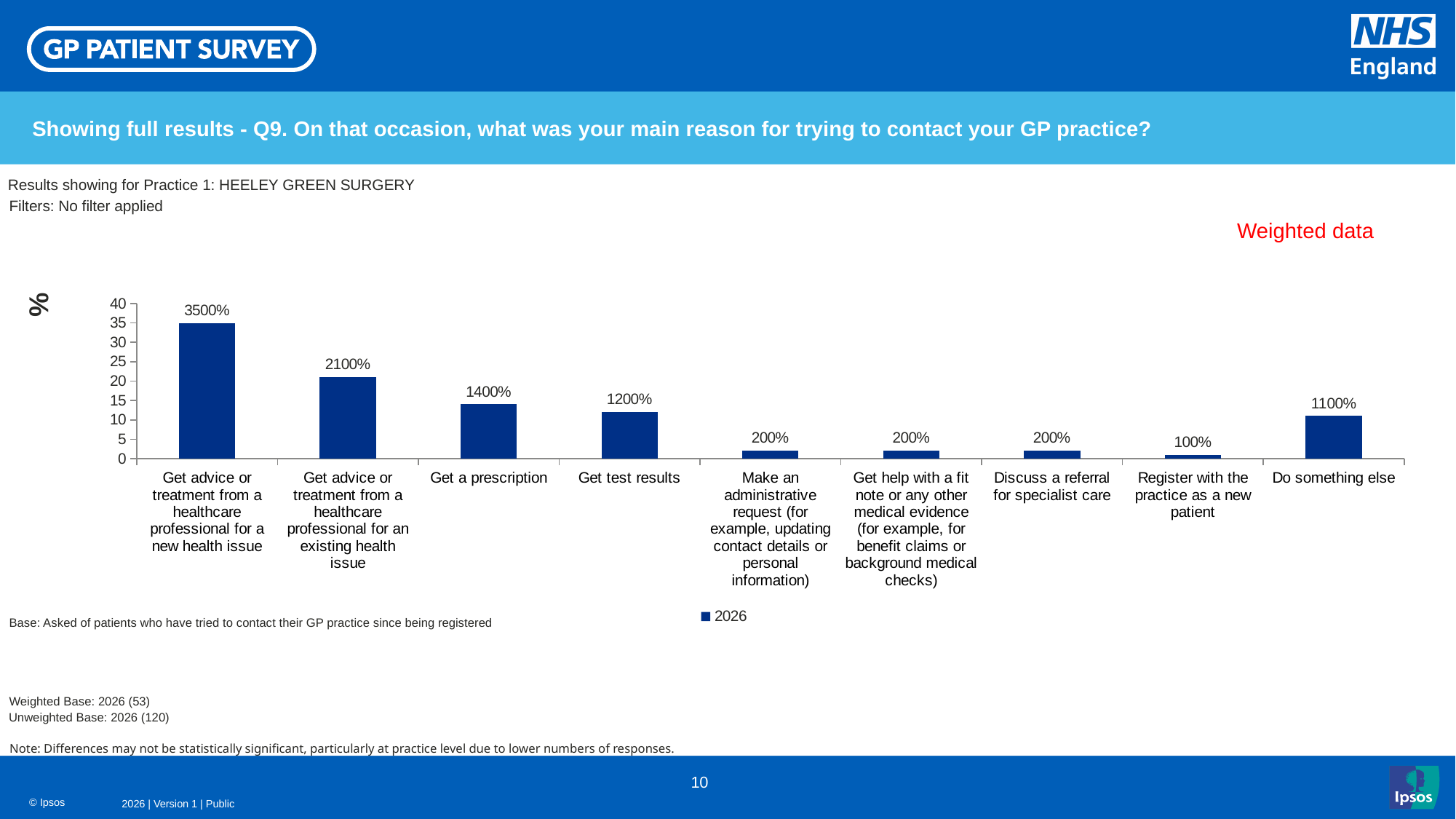
What value is shown for 'Get test results'? 1200% What value is shown for 'Register with the practice as a new patient'? 100% Which category has the highest value? Get advice or treatment from a healthcare professional for a new health issue What value is shown for 'Get a prescription'? 1400% How many series does the legend list? 1 Which category has the lowest value? Register with the practice as a new patient How many categories are shown on the x axis? 9 What kind of chart is shown? Bar chart What value is shown for 'Do something else'? 1100% What is the difference between the values for 'Get a prescription' and 'Get test results'? 200% Which is larger: the value for 'Get test results' or the value for 'Do something else'? Get test results Is the value for 'Get advice or treatment from a healthcare professional for a new health issue' greater or less than 30 on the axis? greater